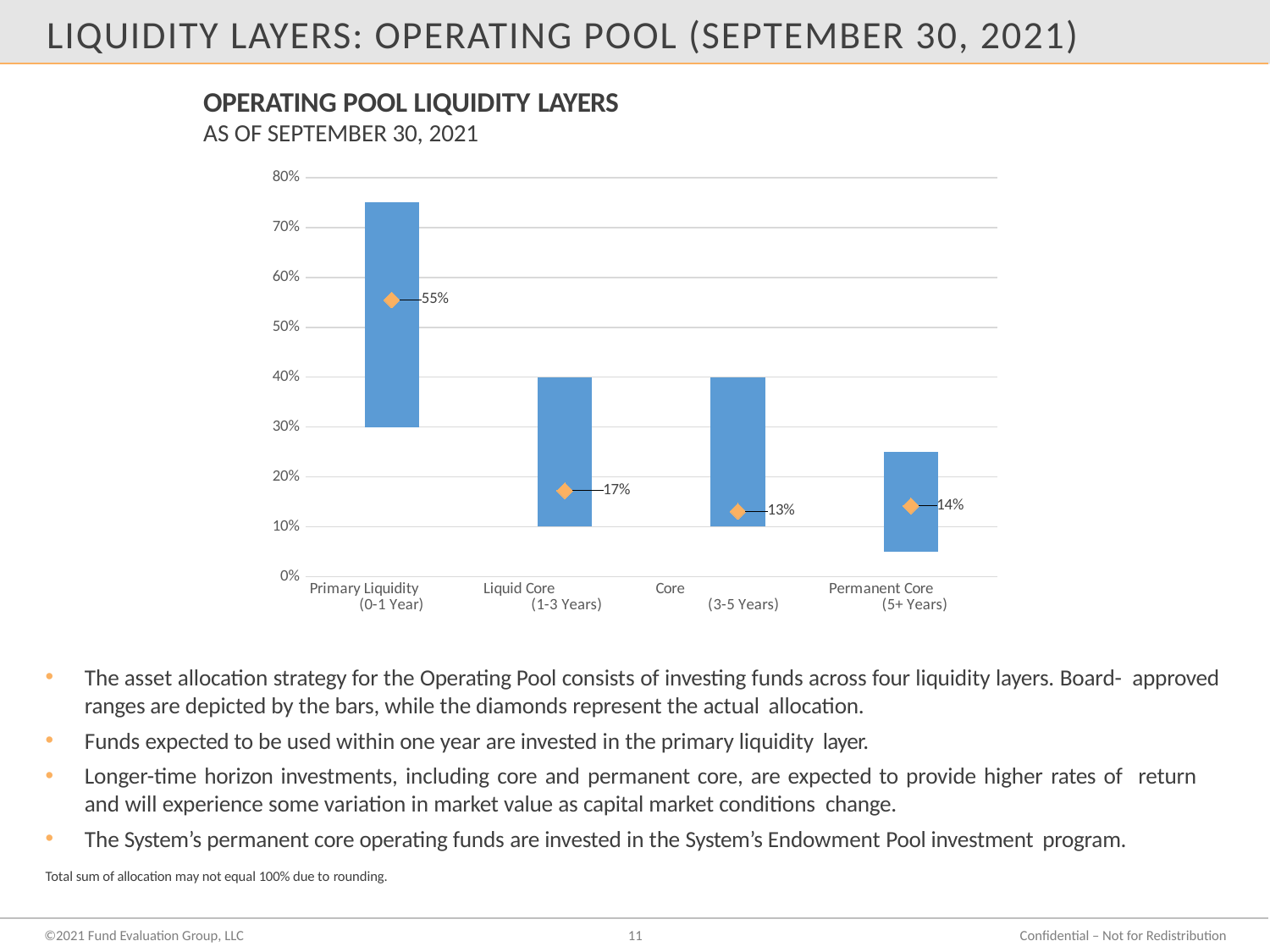
What is the actual allocation (diamond) for Primary Liquidity (0-1 Year)? 55% What is the actual allocation (diamond) for Liquid Core (1-3 Years)? 17% What is the actual allocation (diamond) for Permanent Core (5+ Years)? 14% Which has a larger actual allocation, Liquid Core or Permanent Core? Liquid Core Is the top of the Board-approved range bar for Primary Liquidity greater or less than 70%? greater How many liquidity layers are shown on the x axis? 4 What is the upper end of the Board-approved range bar for Core (3-5 Years)? 40% Which liquidity layer has the highest actual allocation? Primary Liquidity (0-1 Year) What is the title of the chart? OPERATING POOL LIQUIDITY LAYERS What is the actual allocation (diamond) for Core (3-5 Years)? 13% Which liquidity layer has the lowest actual allocation? Core (3-5 Years) What is the difference between the actual allocation for Primary Liquidity and Liquid Core? 38%